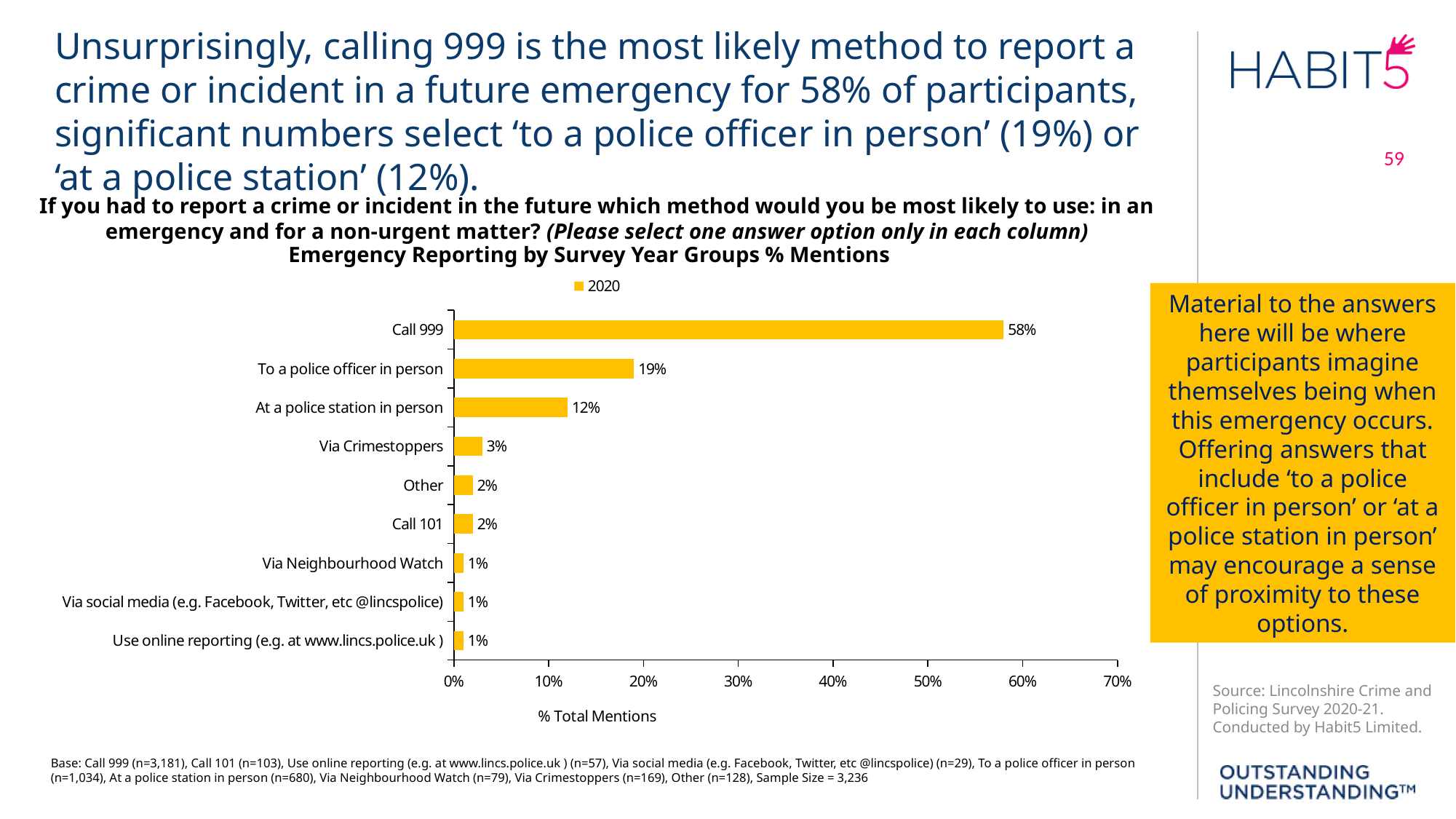
What is the difference between 'At a police station in person' and 'Via Crimestoppers'? 9% What is the label of the x axis of the chart? % Total Mentions Which is larger, the value for 'At a police station in person' or the value for 'Via Crimestoppers'? At a police station in person How many categories are shown in the chart? 9 What is the value for 'Via Crimestoppers'? 3% What is the value for 'To a police officer in person'? 19% What kind of chart is shown on the slide? Bar chart What is the difference between the values for 'Call 999' and 'To a police officer in person'? 39% How many series does the legend list? 1 Is the value for 'Call 999' greater or less than 50%? greater Which category has the highest value in the chart? Call 999 What percentage of mentions does 'Call 999' receive in the chart? 58%